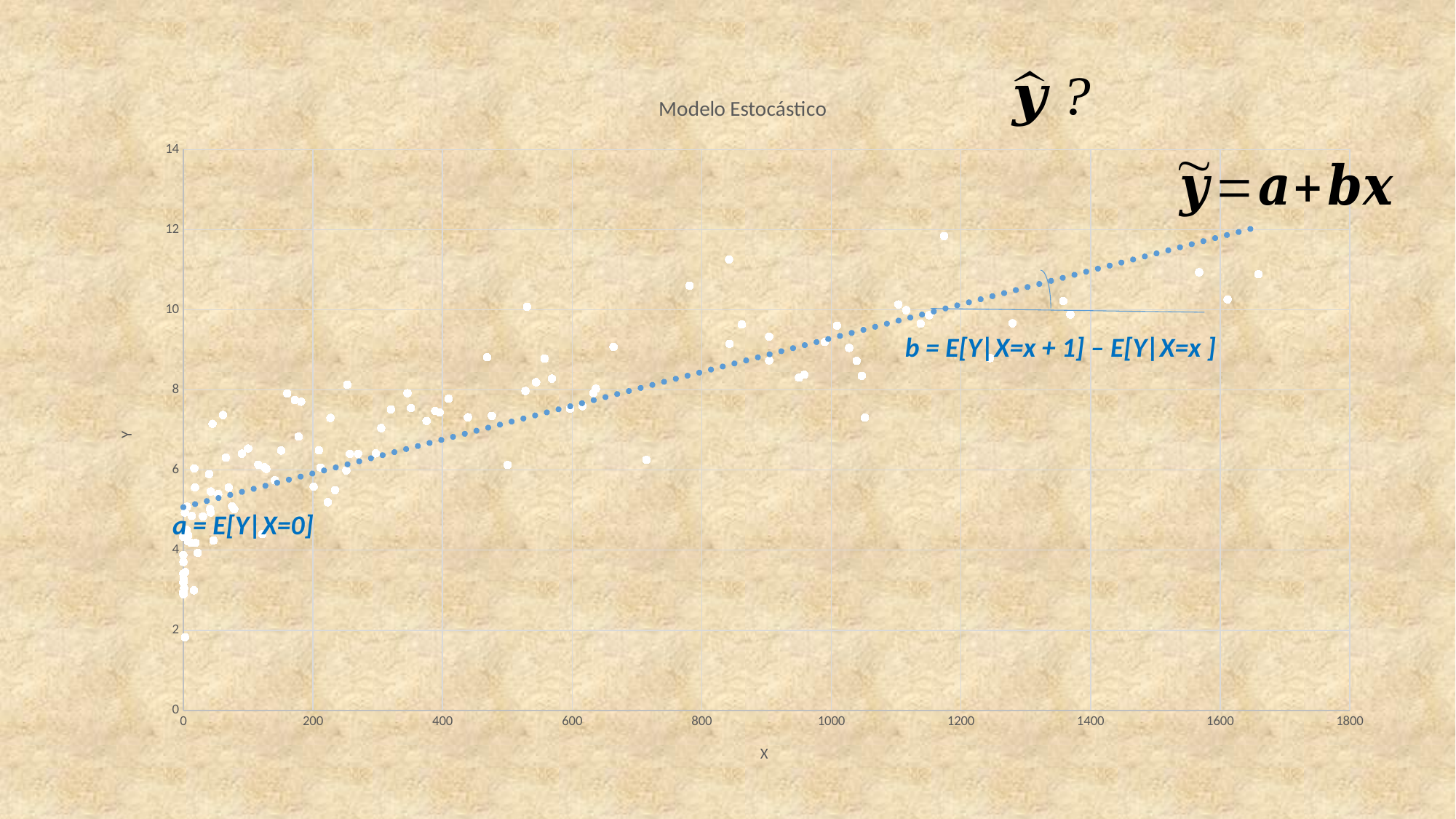
Is the value of the dotted trend line at X=800 greater or less than 6? greater What kind of chart is shown on the slide? Scatter plot What label is shown on the horizontal axis of the chart? X Is the value of the dotted trend line at X=1600 greater or less than 10? greater Is the value of the dotted trend line at X=0 greater or less than 6? less Do the Y values generally rise or fall as X increases along the x axis? Rise What is the title of the chart? Modelo Estocástico Which is larger: the Y value of the highest plotted point near X=1200 or the Y value of the lowest plotted point near X=0? The point near X=1200